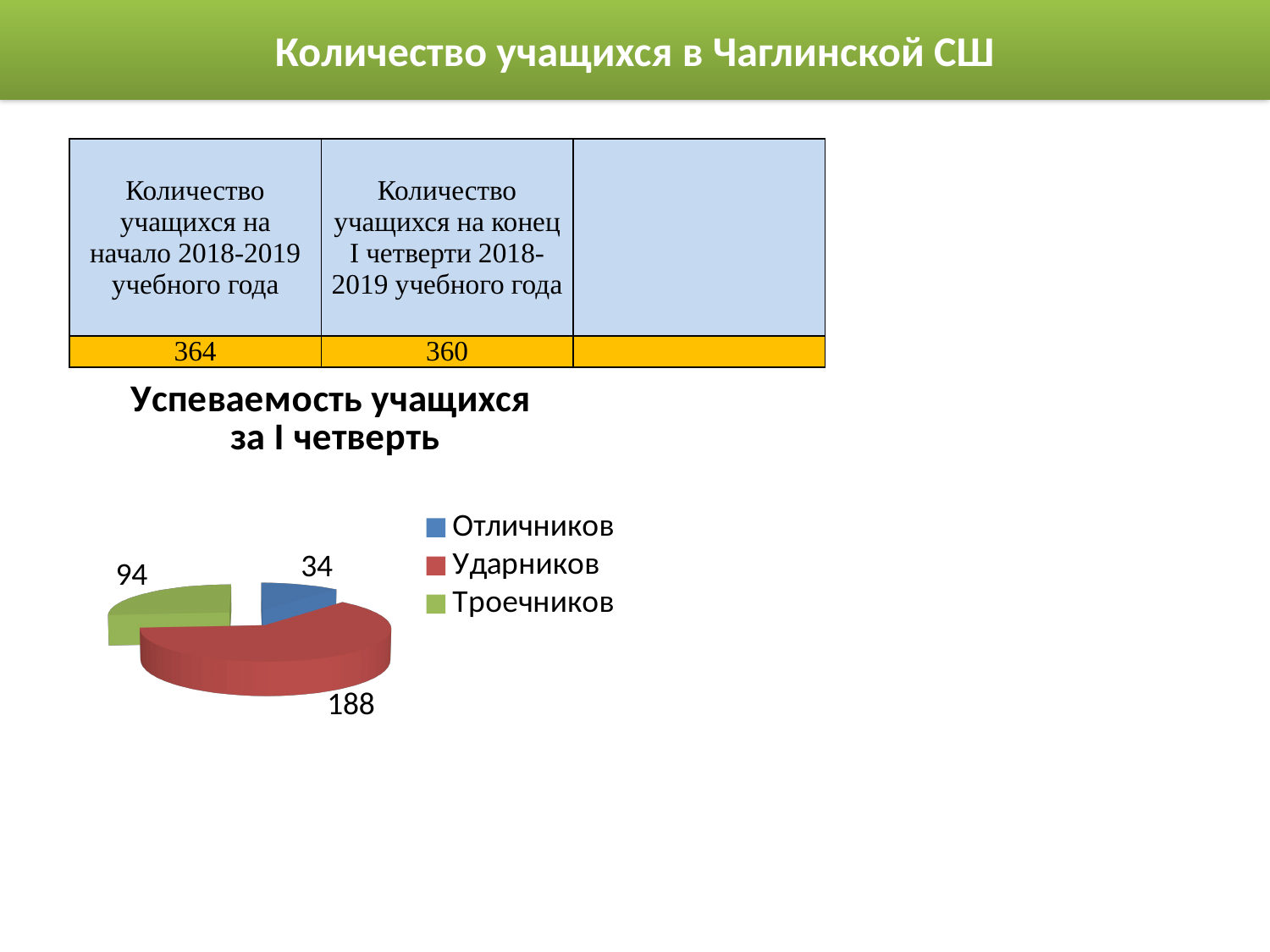
Which category has the smallest slice of the pie? Отличников Which category has the largest slice of the pie? Ударников What is the value for Ударников? 188 What is the difference between the values for Ударников and Троечников? 94 How many entries does the chart legend list? 3 What is the title of the chart? Успеваемость учащихся за I четверть What kind of chart is shown on the slide? pie chart What is the total of all three slices in the pie chart? 316 What is the value for Отличников? 34 What is the value for Троечников? 94 How many slices does the pie chart have? 3 Which is larger, the value for Троечников or the value for Отличников? Троечников